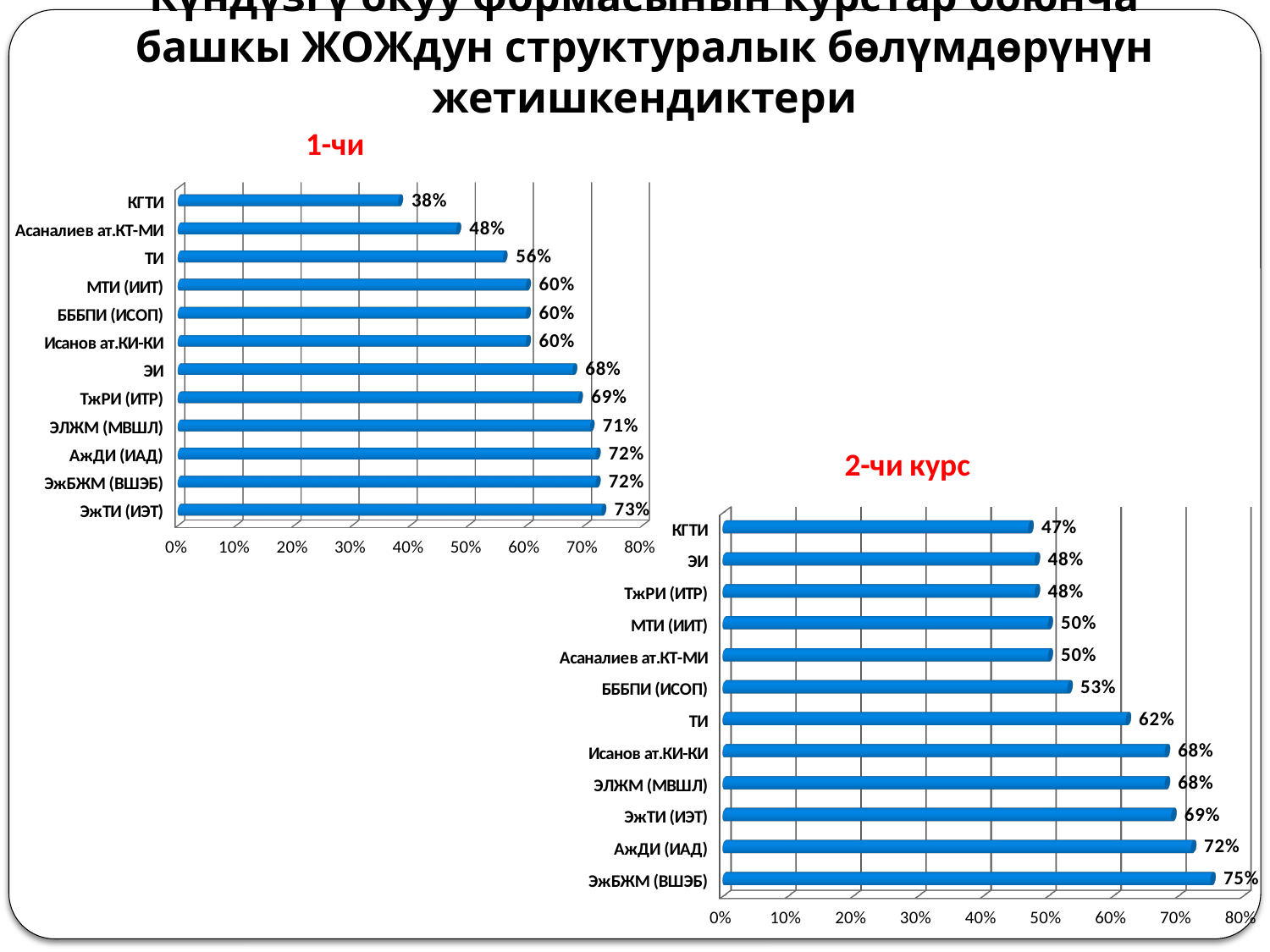
In the "1-чи" chart, how many categories are shown? 12 What type of chart is the "2-чи курс" chart? Bar chart In the "1-чи" chart, which category has the highest value? ЭжТИ (ИЭТ) In the "2-чи курс" chart, what is the difference between the values for ЭжБЖМ (ВШЭБ) and АжДИ (ИАД)? 3% In the "1-чи" chart, what is the value for ТжРИ (ИТР)? 69% In the "2-чи курс" chart, which category has the lowest value? КГТИ In the "2-чи курс" chart, which is larger, the value for ТИ or the value for МТИ (ИИТ)? ТИ In the "2-чи курс" chart, what is the value for ЭжБЖМ (ВШЭБ)? 75% In the "1-чи" chart, what is the value for КГТИ? 38% In the "2-чи курс" chart, what is the value for БББПИ (ИСОП)? 53% In the "1-чи" chart, what is the difference between the values for ЭжТИ (ИЭТ) and КГТИ? 35% In the "1-чи" chart, which category has the lowest value? КГТИ